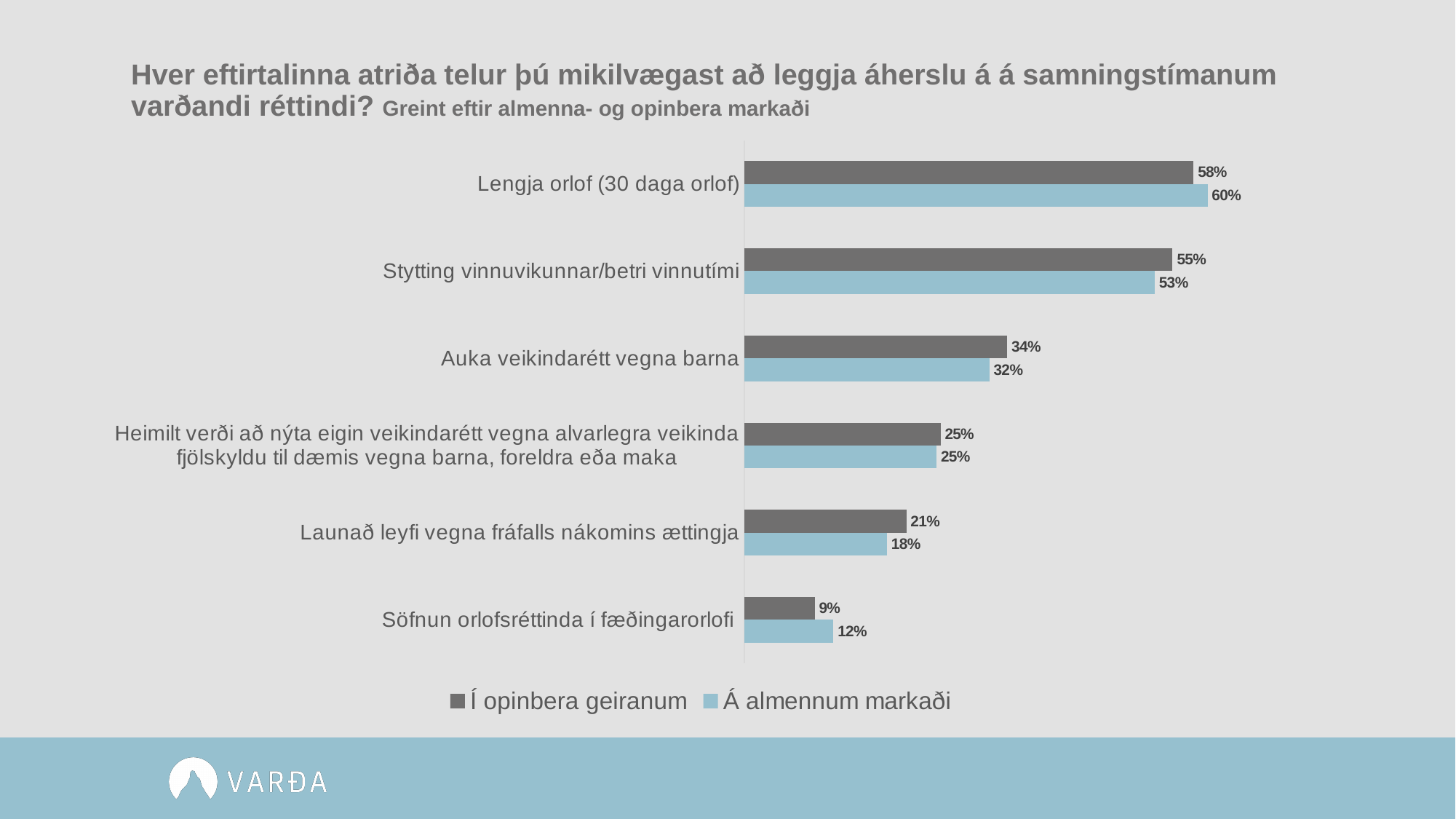
What is the value for "Stytting vinnuvikunnar/betri vinnutími" in the "Í opinbera geiranum" series? 55% What is the value for "Söfnun orlofsréttinda í fæðingarorlofi" in the "Á almennum markaði" series? 12% For "Auka veikindarétt vegna barna", which series has the larger value? Í opinbera geiranum Which colour represents the "Á almennum markaði" series in the chart? Light blue What kind of chart is shown on the slide? Bar chart How many categories are shown in the chart? 6 What is the difference between the "Í opinbera geiranum" and "Á almennum markaði" values for "Stytting vinnuvikunnar/betri vinnutími"? 2% Which category has the lowest value in the "Á almennum markaði" series? Söfnun orlofsréttinda í fæðingarorlofi What is the difference between the "Í opinbera geiranum" and "Á almennum markaði" values for "Launað leyfi vegna fráfalls nákomins ættingja"? 3% Which category has the highest value in the "Í opinbera geiranum" series? Lengja orlof (30 daga orlof) How many series does the legend list? 2 What is the value for "Lengja orlof (30 daga orlof)" in the "Á almennum markaði" series? 60%